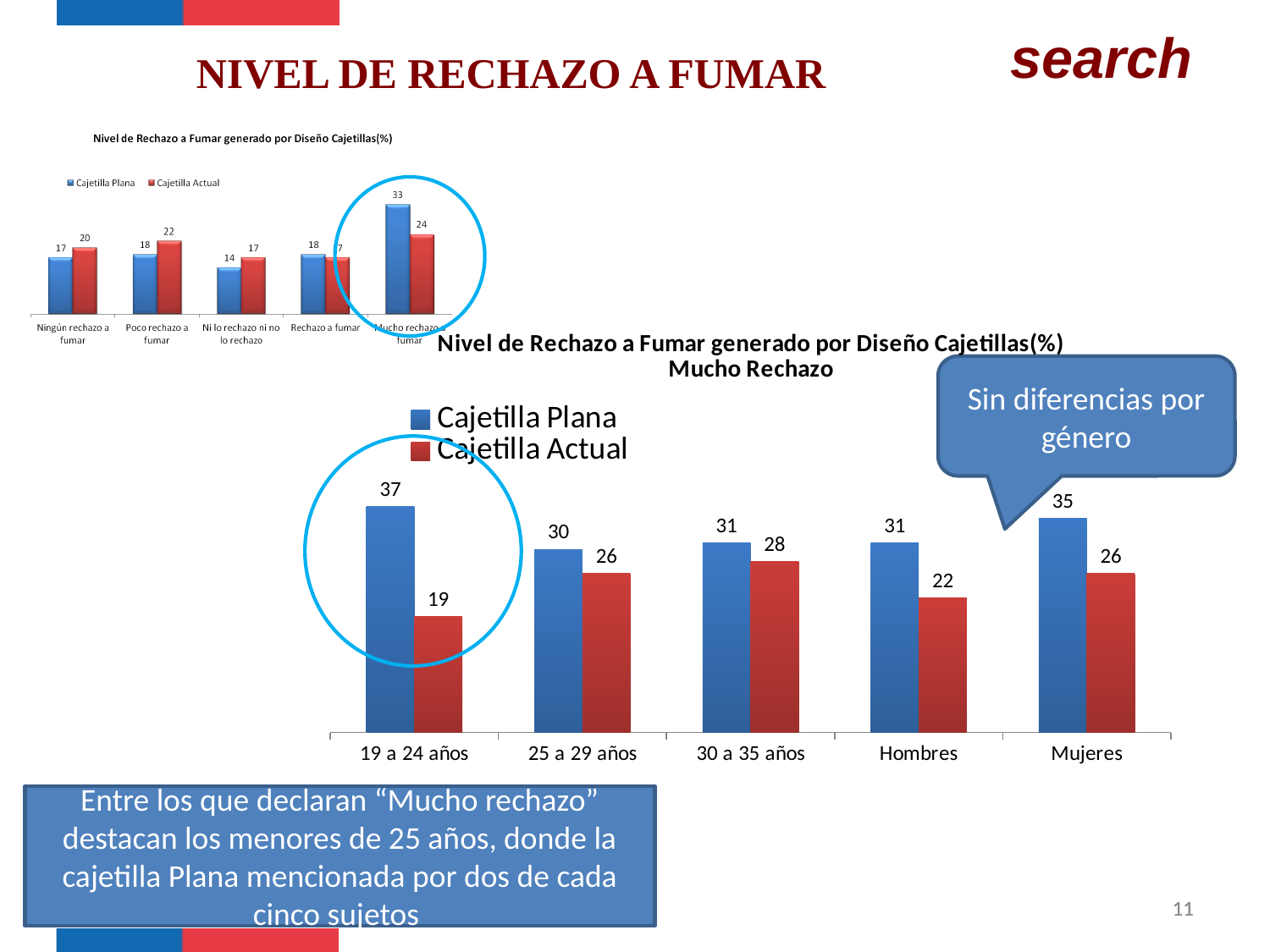
In the large 'Mucho Rechazo' chart, what is the difference between Cajetilla Plana and Cajetilla Actual for the 19 a 24 años group? 18 How many categories are shown on the x axis of the large 'Mucho Rechazo' chart? 5 In the small chart at the top left, what is the Cajetilla Plana value for 'Mucho rechazo a fumar'? 33 In the large 'Mucho Rechazo' chart, which category has the highest Cajetilla Plana value? 19 a 24 años What type of chart is the large 'Mucho Rechazo' chart? Bar chart In the large 'Mucho Rechazo' chart, which is larger for Mujeres: Cajetilla Plana or Cajetilla Actual? Cajetilla Plana How many series does the legend of the large 'Mucho Rechazo' chart list? 2 In the large 'Mucho Rechazo' chart, which category has the lowest Cajetilla Actual value? 19 a 24 años In the small chart at the top left, which category has the lowest Cajetilla Plana value? Ni lo rechazo ni no lo rechazo In the large 'Mucho Rechazo' chart, what is the value for Cajetilla Actual for Hombres? 22 In the small chart at the top left, what is the Cajetilla Actual value for 'Poco rechazo a fumar'? 22 In the large 'Mucho Rechazo' chart, what is the value for Cajetilla Plana in the 19 a 24 años group? 37